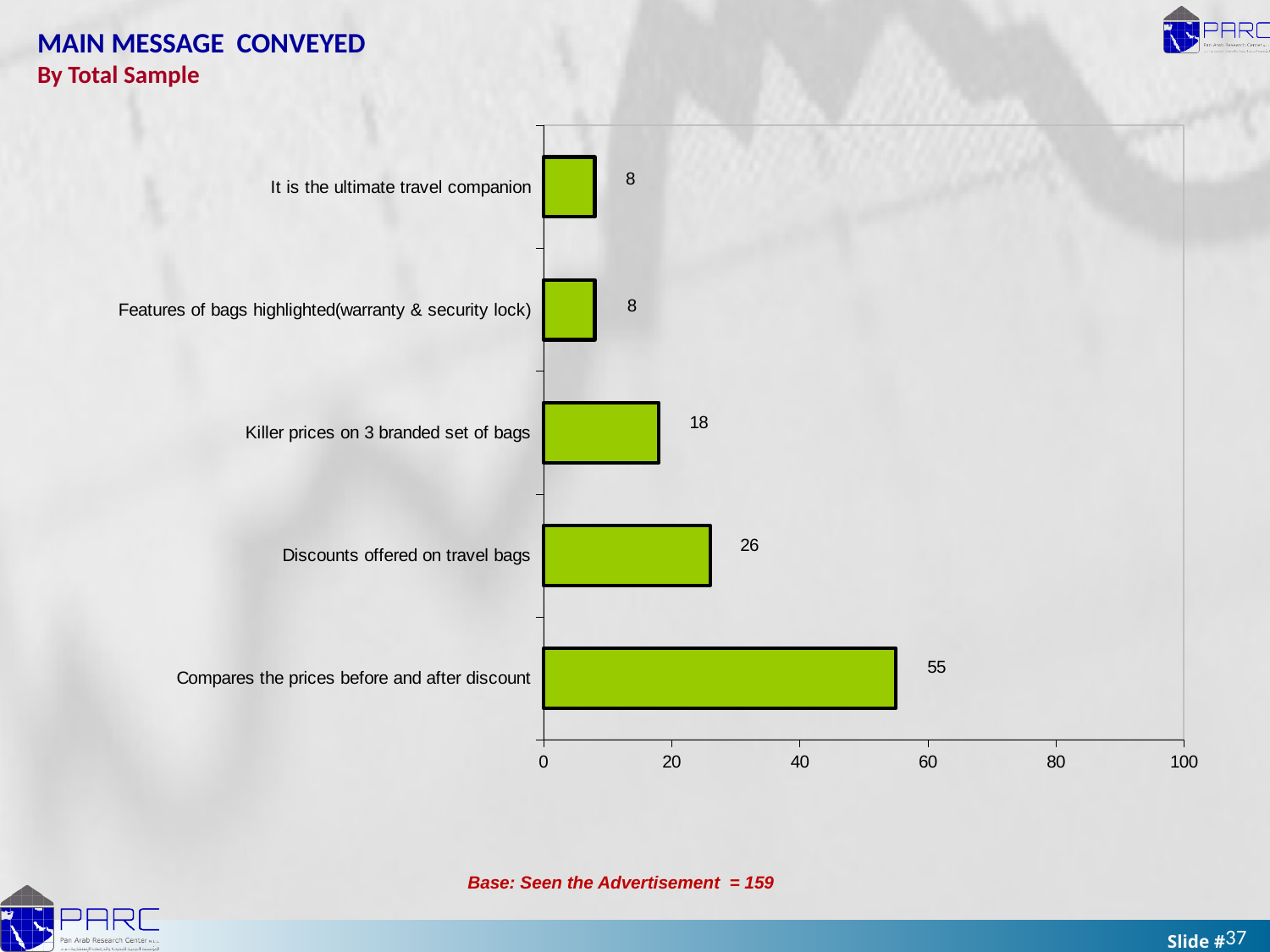
Which is larger: the value for "Killer prices on 3 branded set of bags" or the value for "Features of bags highlighted(warranty & security lock)"? Killer prices on 3 branded set of bags What is the difference between the values for "Discounts offered on travel bags" and "Killer prices on 3 branded set of bags"? 8 How many categories are shown in the chart? 5 What value is shown for "Killer prices on 3 branded set of bags"? 18 What is the base stated below the chart? Seen the Advertisement = 159 What value is shown for "It is the ultimate travel companion"? 8 Is the value for "Compares the prices before and after discount" greater or less than 40? greater Which category has the highest value? Compares the prices before and after discount What kind of chart is shown on the slide? Bar chart What is the difference between the values for "Compares the prices before and after discount" and "Discounts offered on travel bags"? 29 What value is shown for "Compares the prices before and after discount"? 55 What value is shown for "Discounts offered on travel bags"? 26